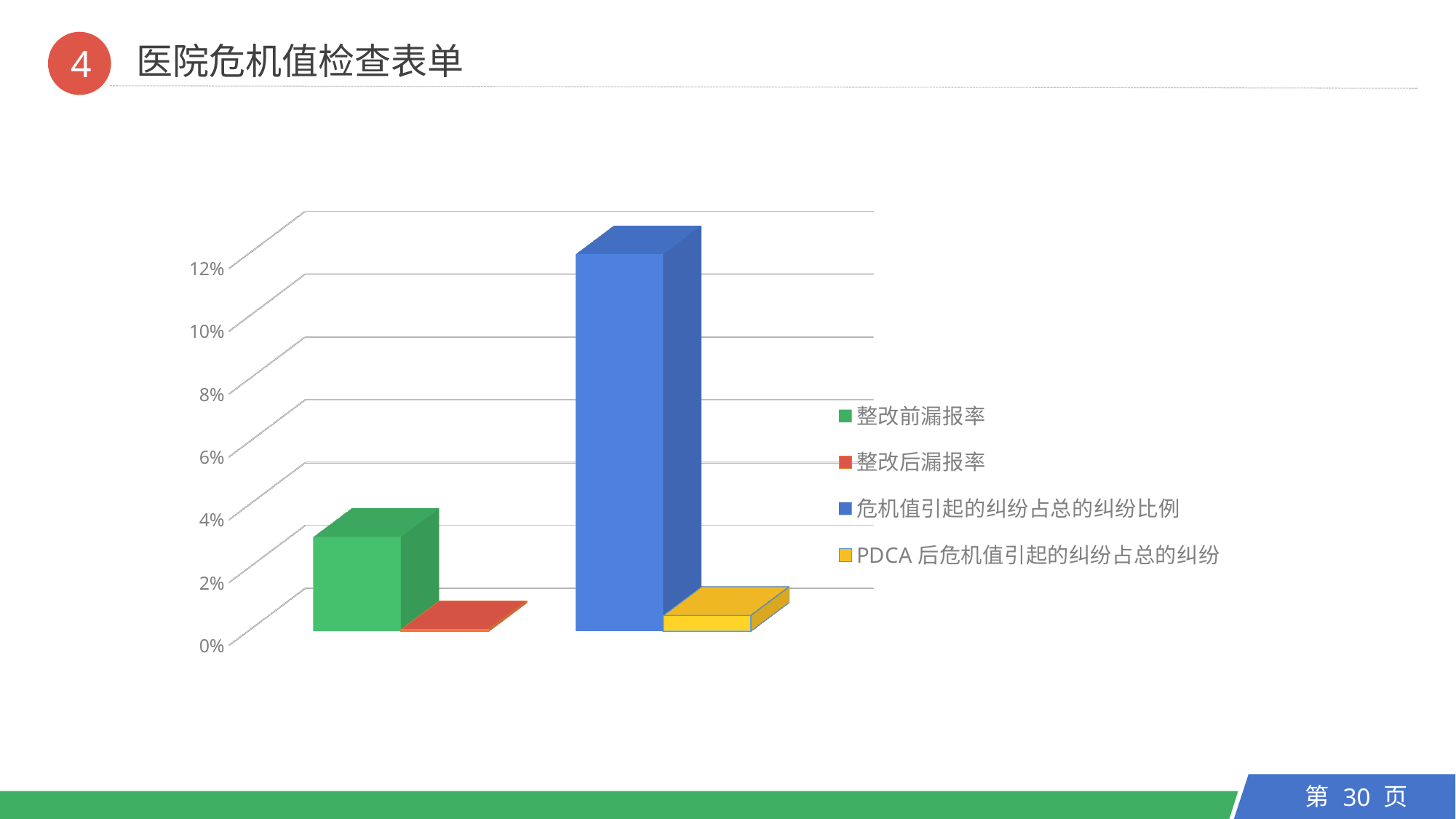
How many bars are plotted in the chart? 4 Which is larger, 整改前漏报率 or 整改后漏报率? 整改前漏报率 Which series has the highest value in the chart? 危机值引起的纠纷占总的纠纷比例 What kind of chart is shown on the slide? bar chart Is the value for 危机值引起的纠纷占总的纠纷比例 greater or less than 10%? greater Which series has the lowest value in the chart? 整改后漏报率 Which is larger, 危机值引起的纠纷占总的纠纷比例 or PDCA 后危机值引起的纠纷占总的纠纷? 危机值引起的纠纷占总的纠纷比例 How many series does the legend list? 4 What colour represents 整改后漏报率 in the legend? red Is the value for PDCA 后危机值引起的纠纷占总的纠纷 greater or less than 2%? less Is the value for 整改前漏报率 greater or less than 4%? less